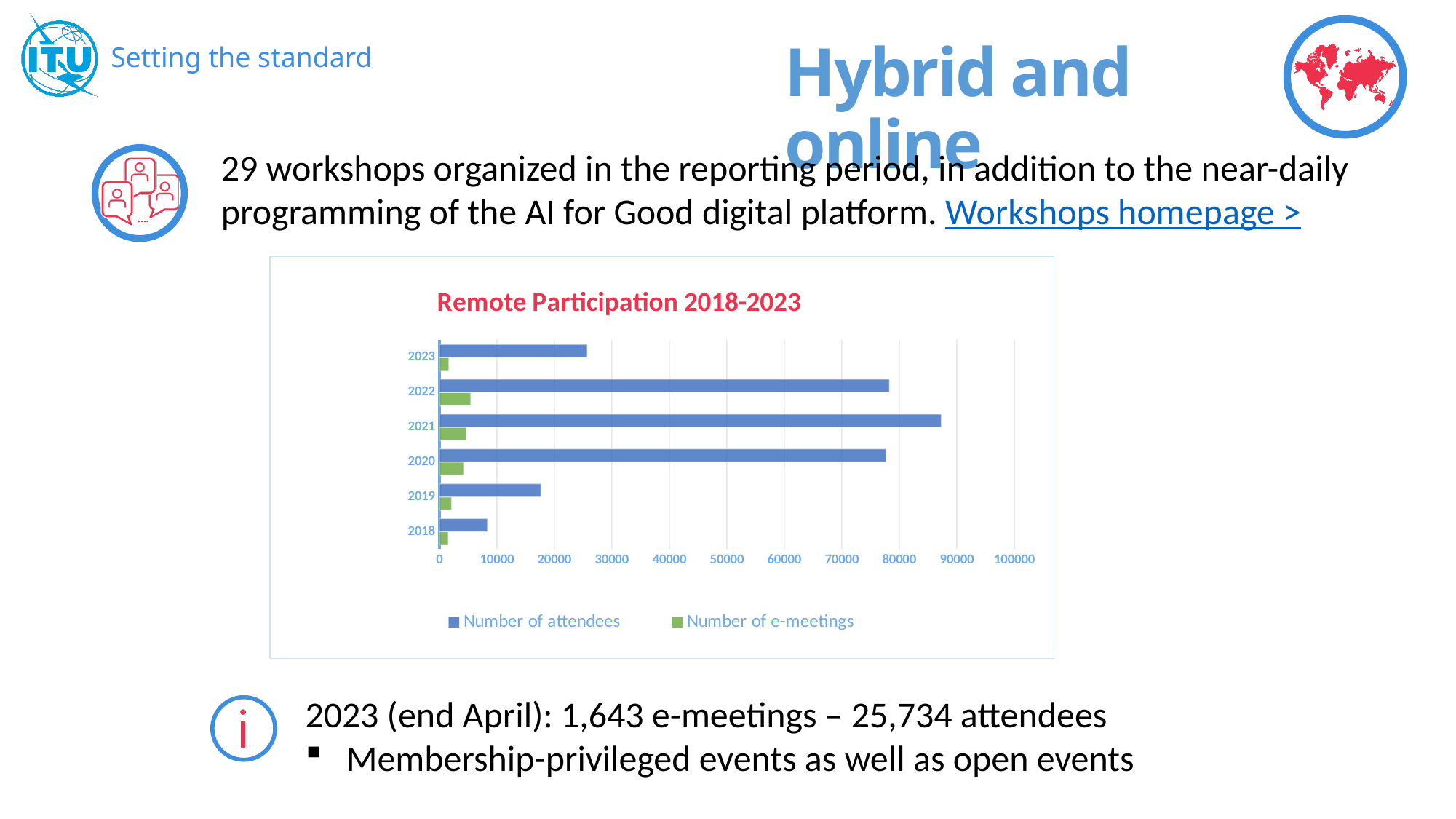
What is the title of the chart? Remote Participation 2018-2023 Is the number of attendees for 2021 greater or less than 80000? greater How many series does the chart legend list? 2 Did the number of attendees rise or fall from 2021 to 2023? fall Is the number of attendees for 2019 greater or less than 20000? less Is the number of attendees for 2018 greater or less than 10000? less What kind of chart is shown on the slide? bar chart How many years are shown on the chart's vertical axis? 6 Which year has the highest number of attendees? 2021 Which year has the lowest number of attendees? 2018 Which colour represents the Number of e-meetings series? green Which year has more attendees, 2023 or 2022? 2022